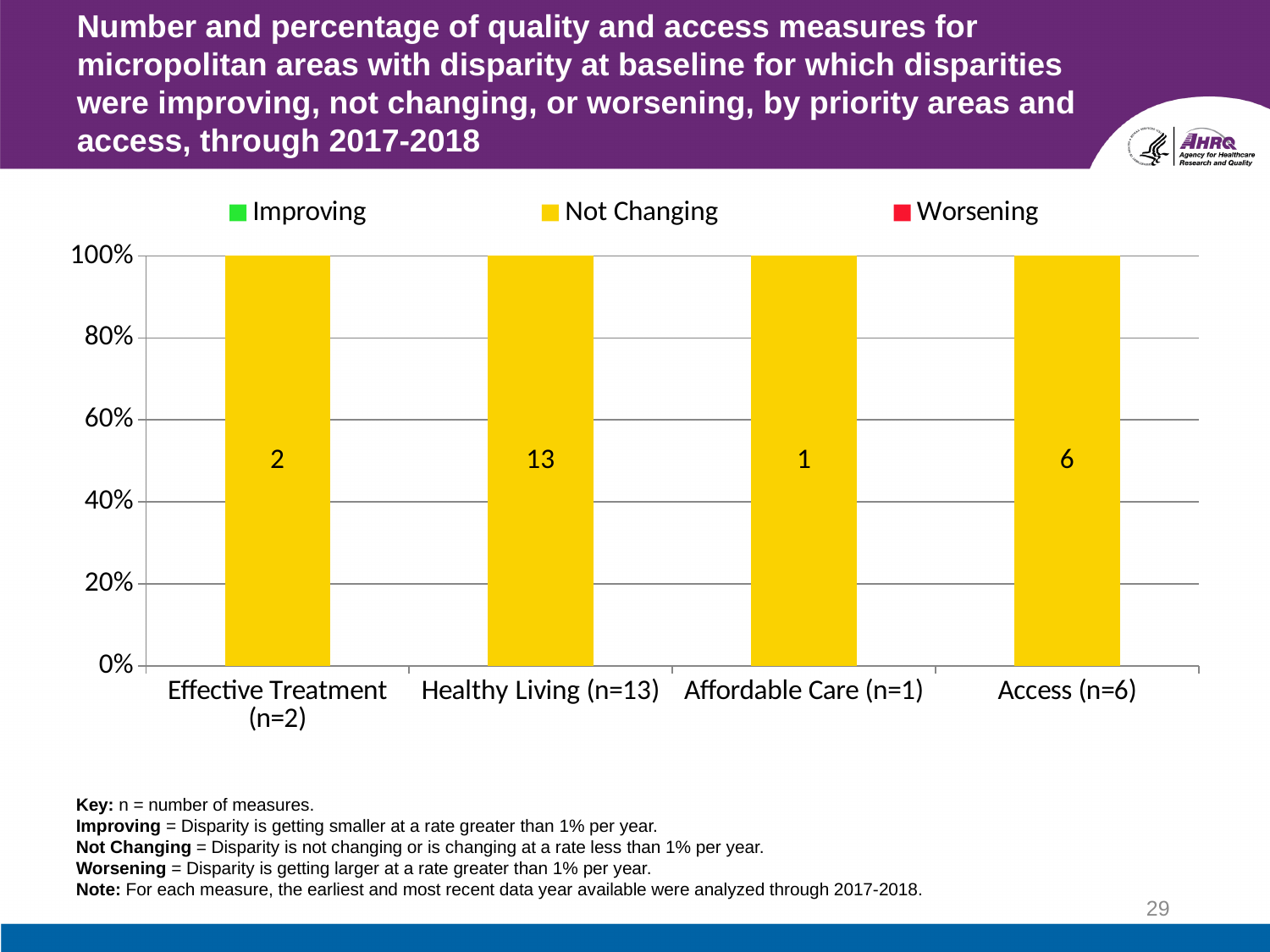
What is the data label on the Not Changing bar for Effective Treatment (n=2)? 2 How many categories are shown on the x axis? 4 What is the difference between the number of Not Changing measures for Healthy Living and for Access? 7 Which has more Not Changing measures, Effective Treatment or Access? Access What percentage does the Not Changing bar reach for Access (n=6)? 100% What kind of chart is shown on the slide? Stacked bar chart How many series does the legend list? 3 What is the data label on the Not Changing bar for Access (n=6)? 6 Which category has the largest number of Not Changing measures? Healthy Living (n=13) What is the data label on the Not Changing bar for Healthy Living (n=13)? 13 Which category has the smallest number of Not Changing measures? Affordable Care (n=1) What is the data label on the Not Changing bar for Affordable Care (n=1)? 1